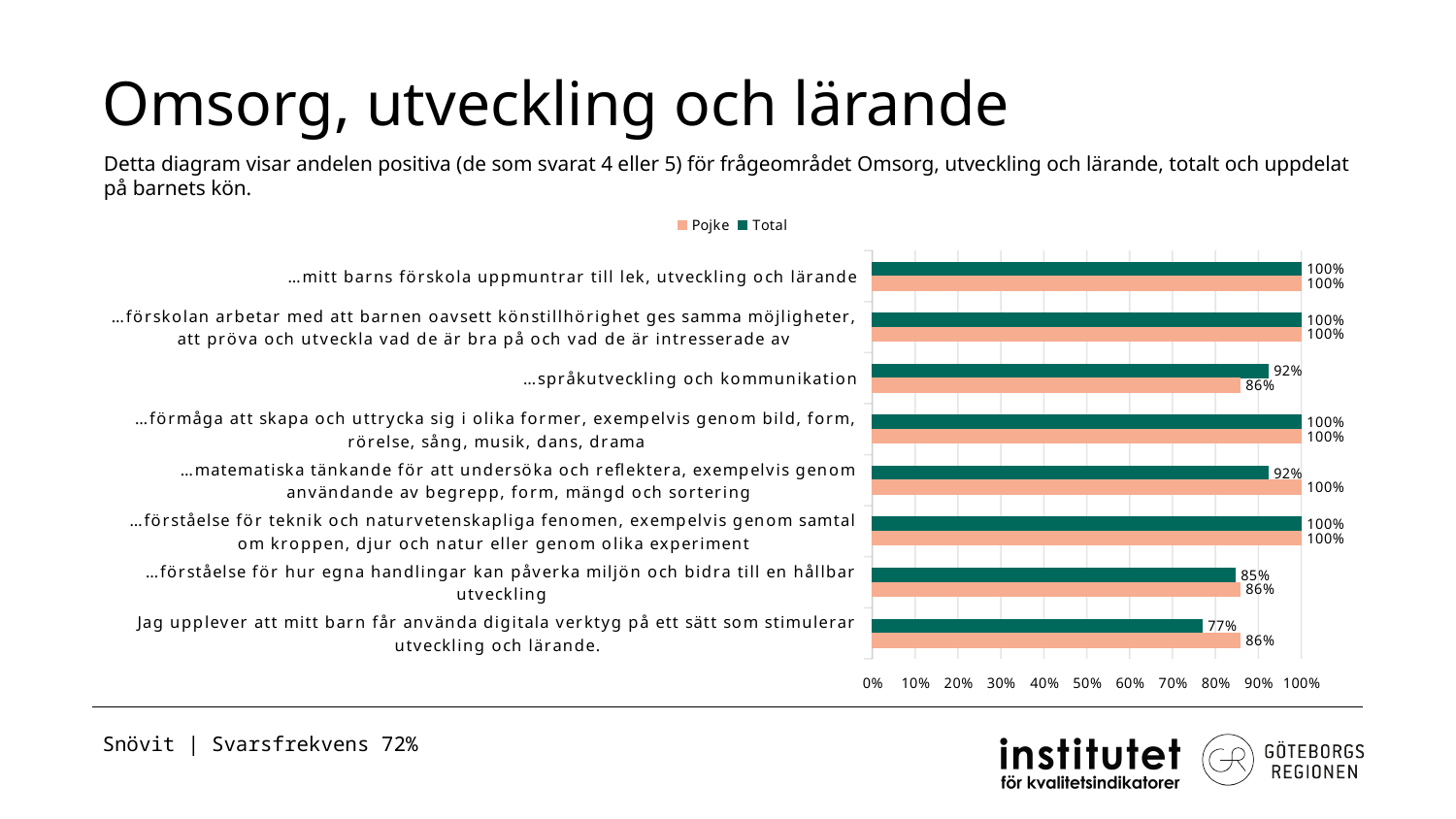
What is the Total value for "Jag upplever att mitt barn får använda digitala verktyg på ett sätt som stimulerar utveckling och lärande."? 77% How many categories (statements) are shown in the chart? 8 What is the difference between the Pojke and Total values for "Jag upplever att mitt barn får använda digitala verktyg på ett sätt som stimulerar utveckling och lärande."? 9% What is the Pojke value for "…matematiska tänkande för att undersöka och reflektera, exempelvis genom användande av begrepp, form, mängd och sortering"? 100% Which series is shown in dark green in the legend? Total What is the Total value for "…språkutveckling och kommunikation"? 92% Which category has the lowest Total value? Jag upplever att mitt barn får använda digitala verktyg på ett sätt som stimulerar utveckling och lärande. What type of chart is shown on the slide? bar chart How many series does the legend list? 2 For "…språkutveckling och kommunikation", which is larger, the Total value or the Pojke value? Total What is the Pojke value for "…språkutveckling och kommunikation"? 86% What is the Total value for "…förståelse för hur egna handlingar kan påverka miljön och bidra till en hållbar utveckling"? 85%